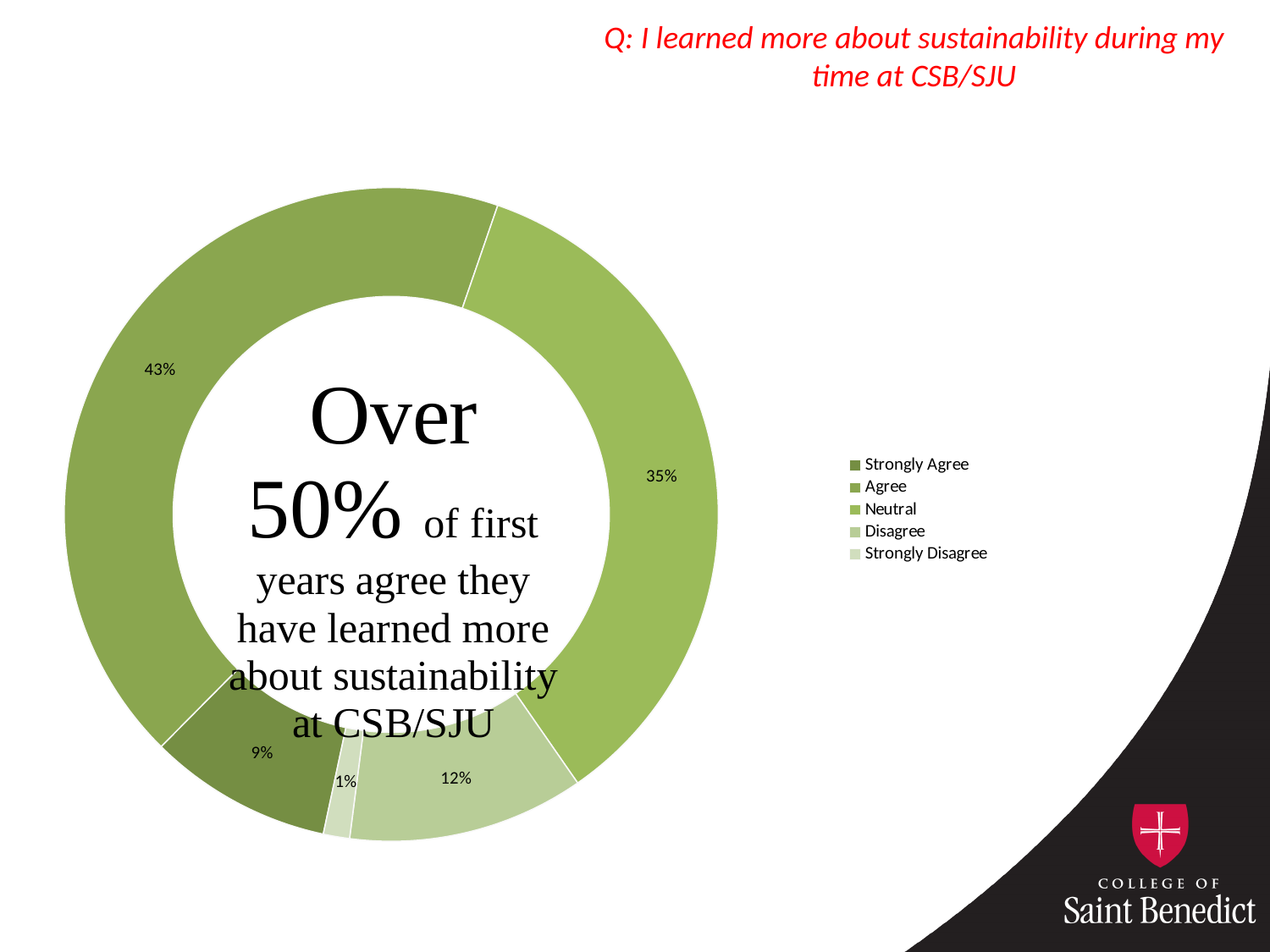
What is the largest slice value in the chart? 43% What is the question shown as the chart's title? Q: I learned more about sustainability during my time at CSB/SJU Which is larger, the Strongly Agree slice or the Neutral slice? Neutral What percentage of respondents chose Strongly Agree? 9% What percentage of respondents chose Agree? 43% What kind of chart is shown on the slide? Doughnut (pie) chart How many slices does the doughnut chart have? 5 What is the smallest slice value in the chart? 1% What percentage of respondents chose Neutral? 35% What is the combined share of Strongly Agree and Agree? 52% How many entries does the legend list? 5